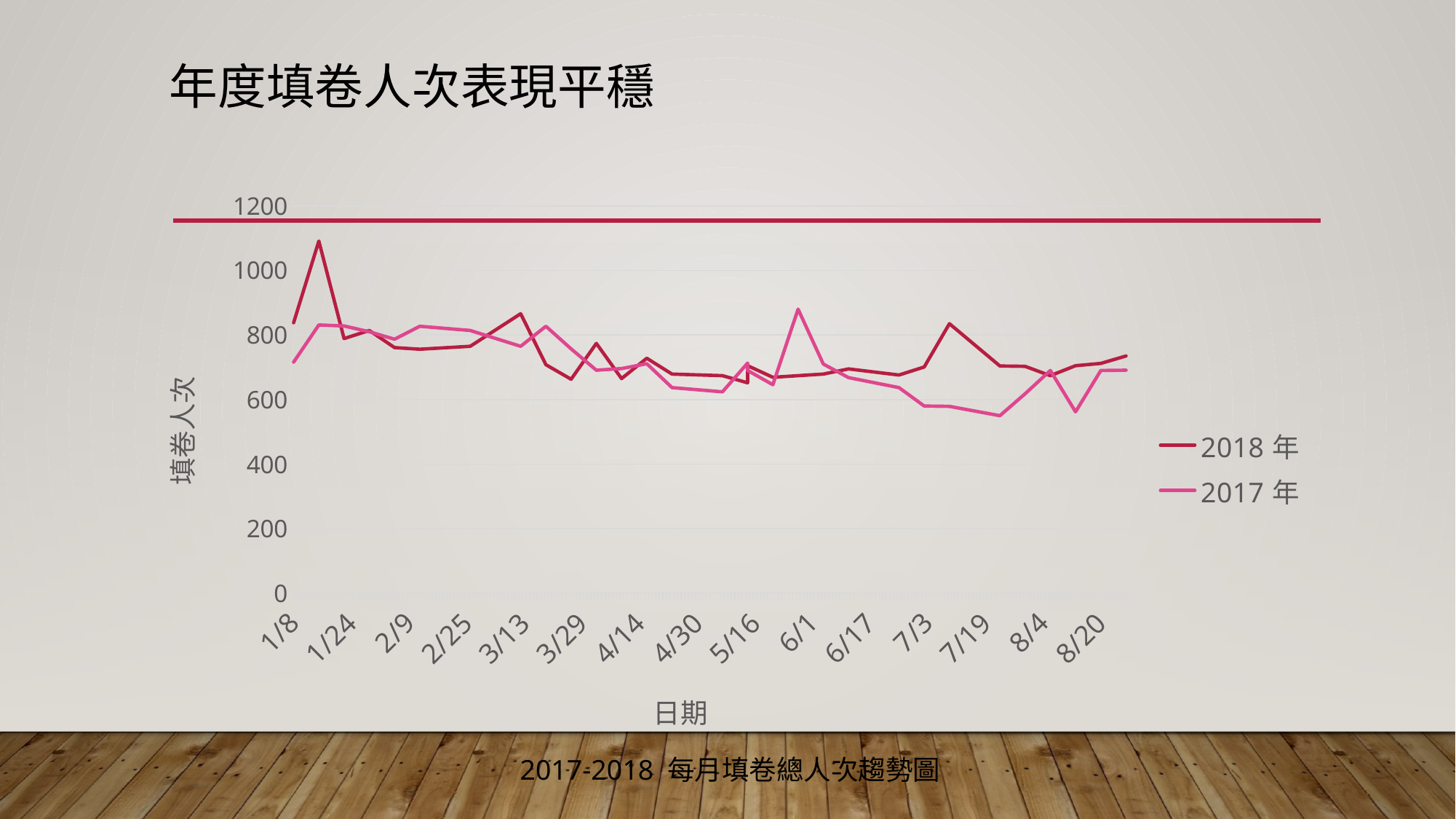
How many series does the legend list? 2 Is the highest value of the 2017 年 series greater or less than 1000? less Which series reaches the highest value anywhere on the chart? 2018 年 Is the highest value of the 2018 年 series greater or less than 1000? greater What kind of chart is shown on the slide? line chart Is the lowest value of the 2017 年 series greater or less than 600? less Does the 2018 年 series end at 8/20 higher or lower than it starts at 1/8? lower What is the title of the vertical axis? 填卷人次 How many date labels are shown on the x axis? 15 What are the two series named in the legend? 2018 年 and 2017 年 Which series reaches the lowest value anywhere on the chart? 2017 年